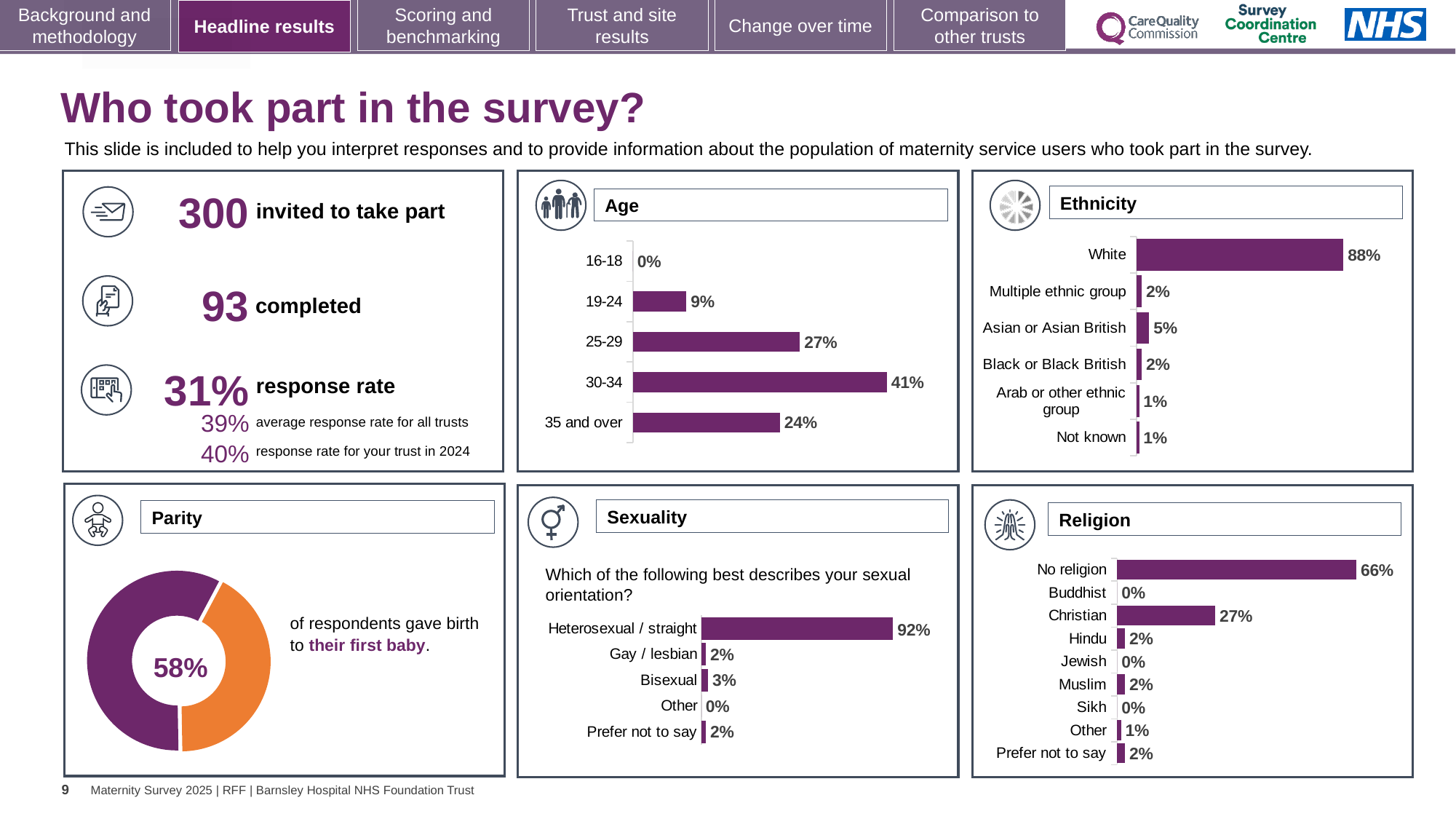
In the Ethnicity chart, what percentage of respondents were White? 88% In the Religion chart, what percentage of respondents reported No religion? 66% In the Parity chart, what percentage of respondents gave birth to their first baby? 58% In the Sexuality chart, what percentage of respondents answered Bisexual? 3% In the Age chart, which age group has the highest percentage? 30-34 In the Religion chart, what is the difference between No religion and Christian? 39% In the Ethnicity chart, which is larger: Asian or Asian British or Black or Black British? Asian or Asian British In the Age chart, what percentage of respondents were aged 30-34? 41% In the Sexuality chart, how many response categories are shown? 5 In the Age chart, what is the difference between the 25-29 and 19-24 percentages? 18% What kind of chart is the Parity chart? Doughnut chart In the Ethnicity chart, how many ethnicity categories are shown? 6